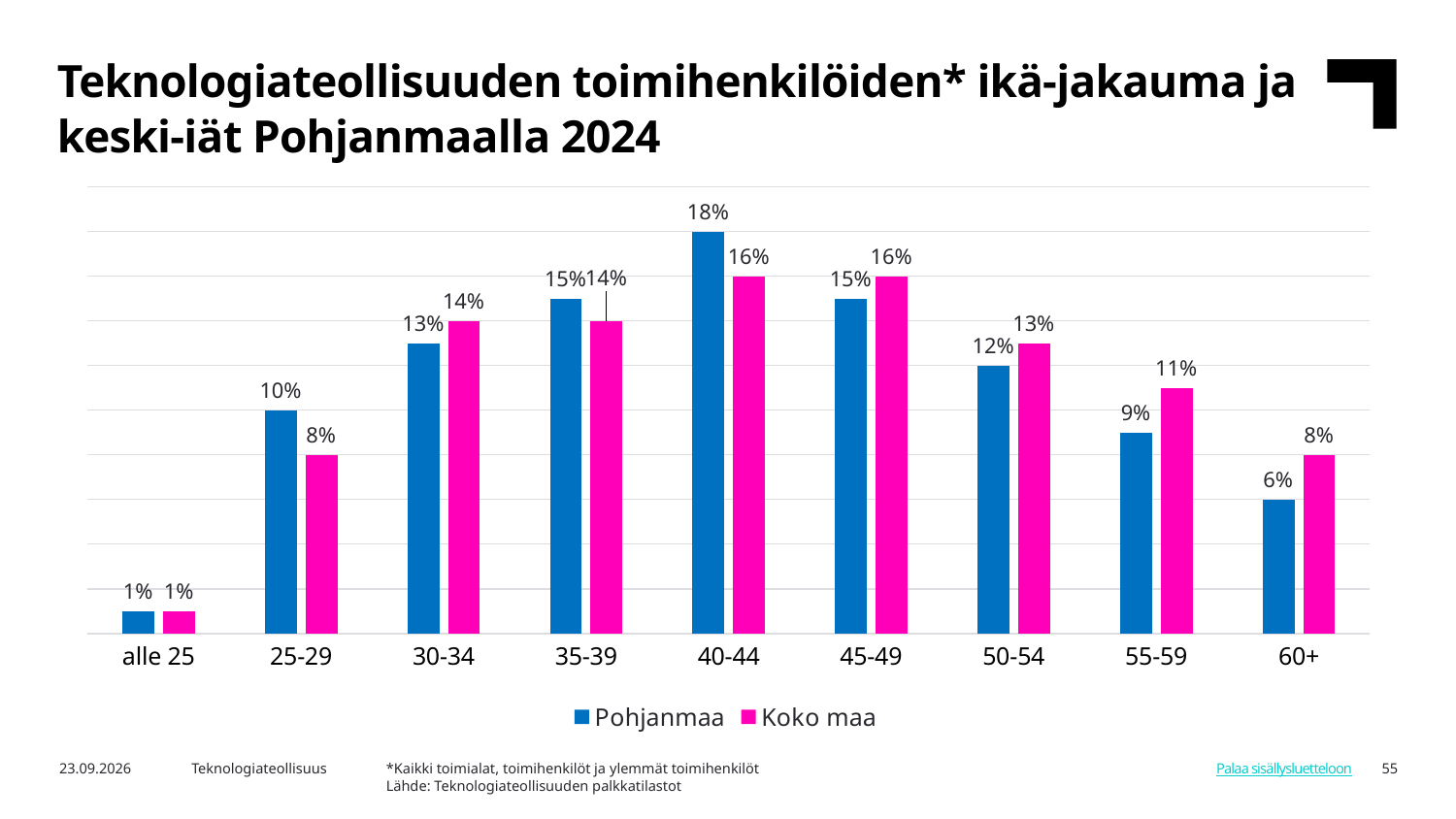
What is the difference between the Pohjanmaa and Koko maa values in the 40-44 age group? 2% What is the difference between the Pohjanmaa values for the 25-29 and 60+ age groups? 4% What kind of chart is shown on the slide? Bar chart In the 55-59 age group, which series has the larger value, Pohjanmaa or Koko maa? Koko maa What is the value for Pohjanmaa in the 25-29 age group? 10% Which age group has the lowest value for Koko maa? alle 25 How many age groups are shown on the x axis? 9 How many series does the legend list? 2 What is the value for Pohjanmaa in the 40-44 age group? 18% Which age group has the highest value for Pohjanmaa? 40-44 What is the value for Koko maa in the 60+ age group? 8% What is the value for Koko maa in the 55-59 age group? 11%